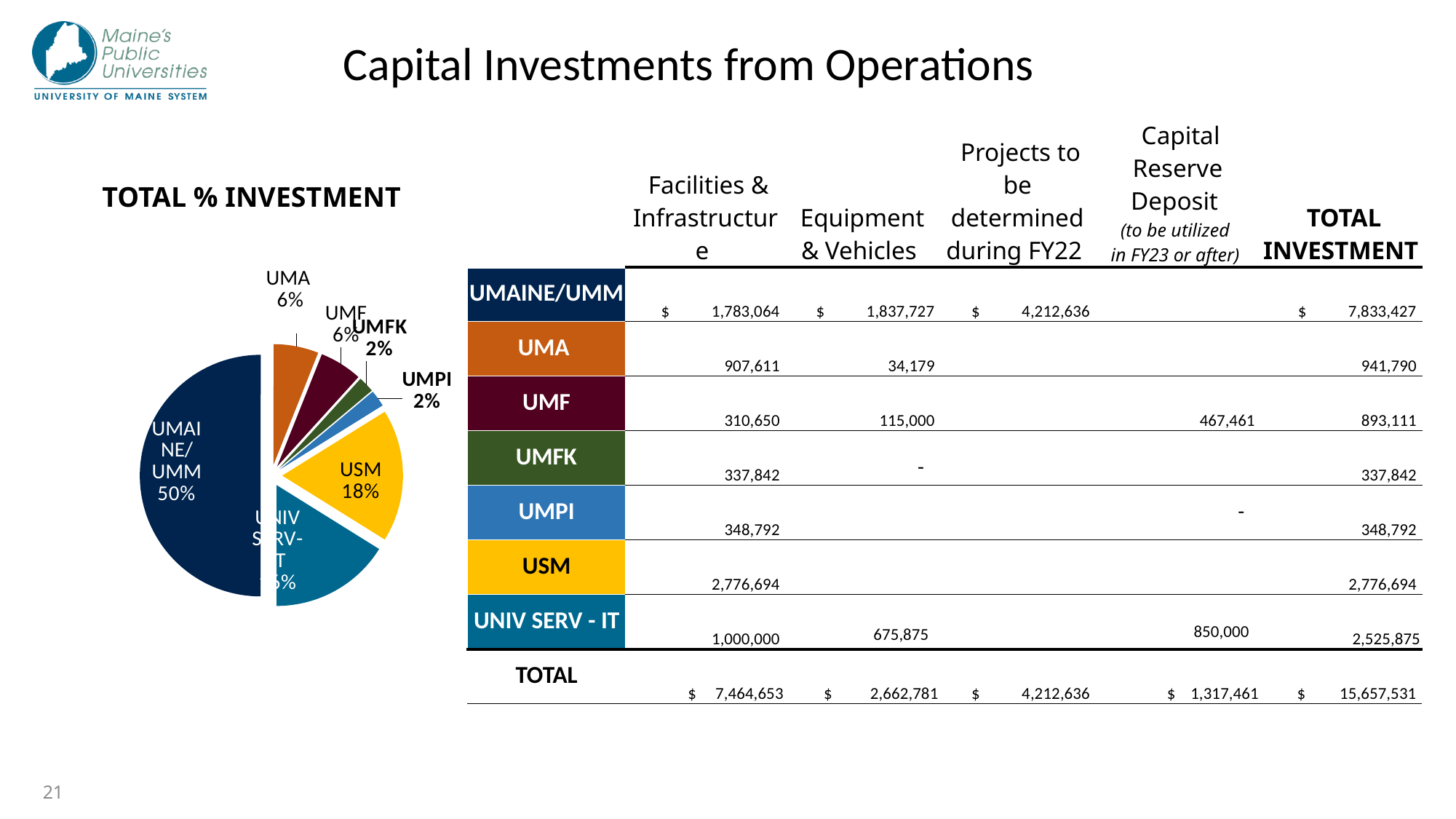
What is the title of the pie chart? TOTAL % INVESTMENT What is the value shown for UMPI in the pie chart? 2% What is the difference between the UMAINE/UMM share and the USM share? 32% What kind of chart is shown on the slide? pie chart Which category has the largest slice of the pie? UMAINE/UMM What is the value shown for UMA in the pie chart? 6% Which is larger in the pie chart, USM or UMA? USM How many slices does the pie chart have? 7 What share of the pie does UMAINE/UMM hold? 50% What is the value shown for UMFK in the pie chart? 2% What is the value shown for USM in the pie chart? 18% What colour is the UMAINE/UMM slice in the pie chart? dark navy blue